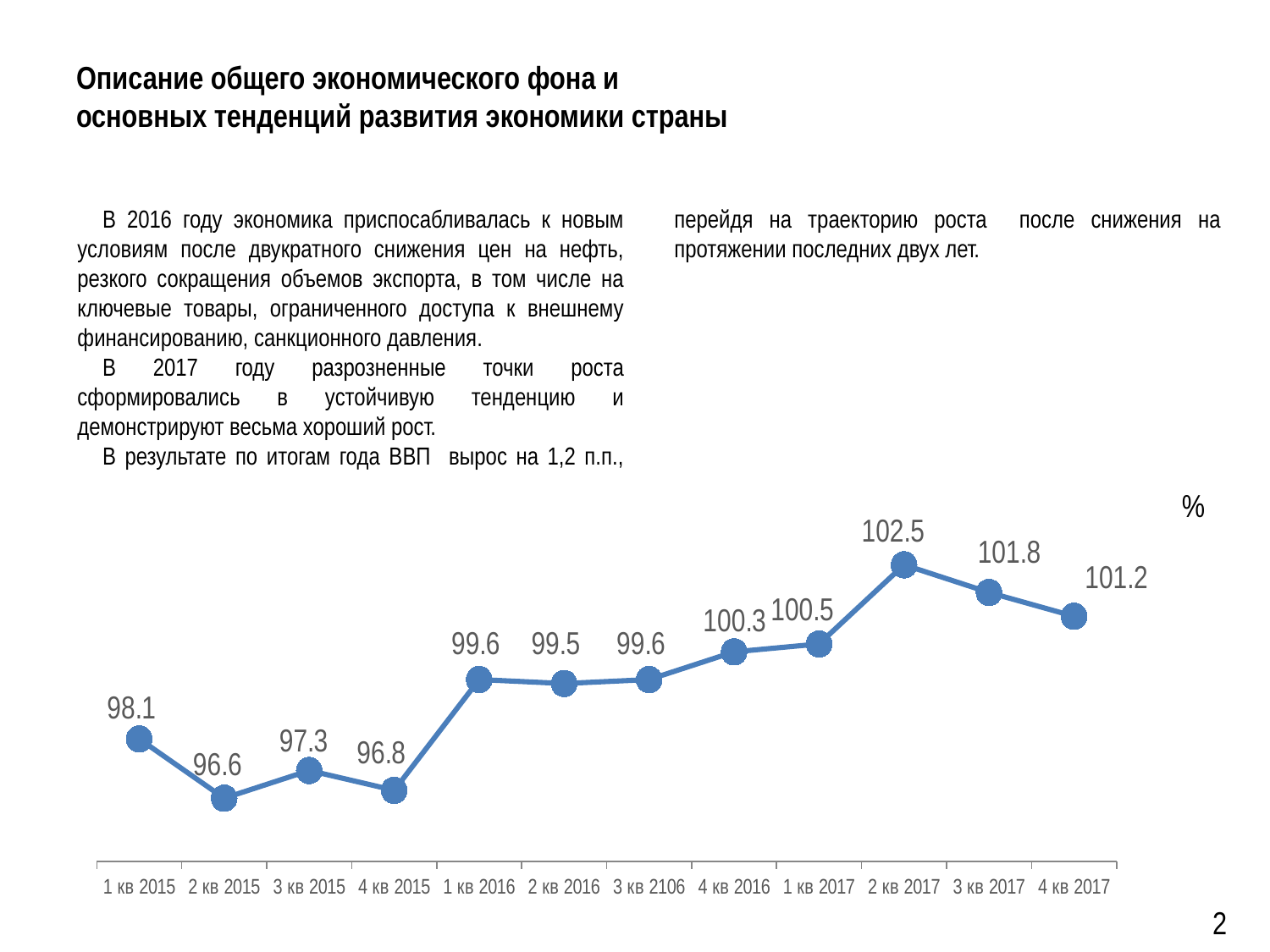
What unit is indicated in the top right corner of the chart? % What is the difference between the values for 3 кв 2017 and 4 кв 2017? 0.6 What is the value for 4 кв 2016? 100.3 Which is larger, the value for 3 кв 2015 or the value for 4 кв 2015? 3 кв 2015 Which quarter has the highest value? 2 кв 2017 What is the value for 4 кв 2017? 101.2 What is the difference between the values for 2 кв 2017 and 2 кв 2015? 5.9 What is the value for 1 кв 2015? 98.1 Which quarter has the lowest value? 2 кв 2015 What type of chart is shown on the slide? line chart What is the value for 2 кв 2017? 102.5 How many data points are plotted on the chart? 12